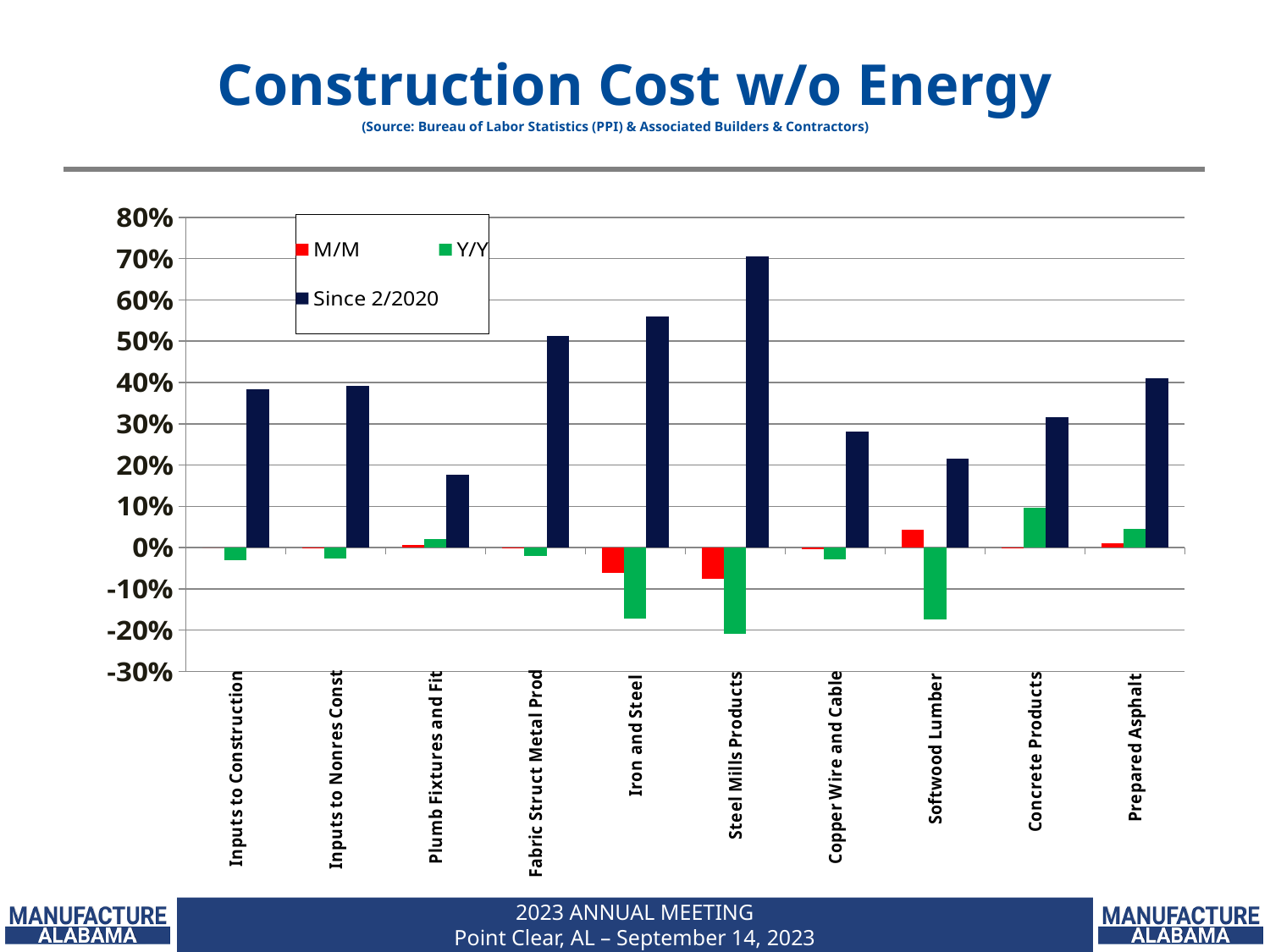
Which category has the highest Y/Y value? Concrete Products Which has the larger Since 2/2020 value, Iron and Steel or Fabric Struct Metal Prod? Iron and Steel How many series does the legend list? 3 What kind of chart is shown on the slide? bar chart Is the Since 2/2020 value for Steel Mills Products greater or less than 60%? greater What is the title of the chart? Construction Cost w/o Energy Is the Y/Y value for Softwood Lumber greater or less than -10%? less How many categories are shown on the x axis? 10 Which category has the lowest Since 2/2020 value? Plumb Fixtures and Fit Which category has the highest Since 2/2020 value? Steel Mills Products Which category has the highest M/M value? Softwood Lumber Which category has the lowest Y/Y value? Steel Mills Products